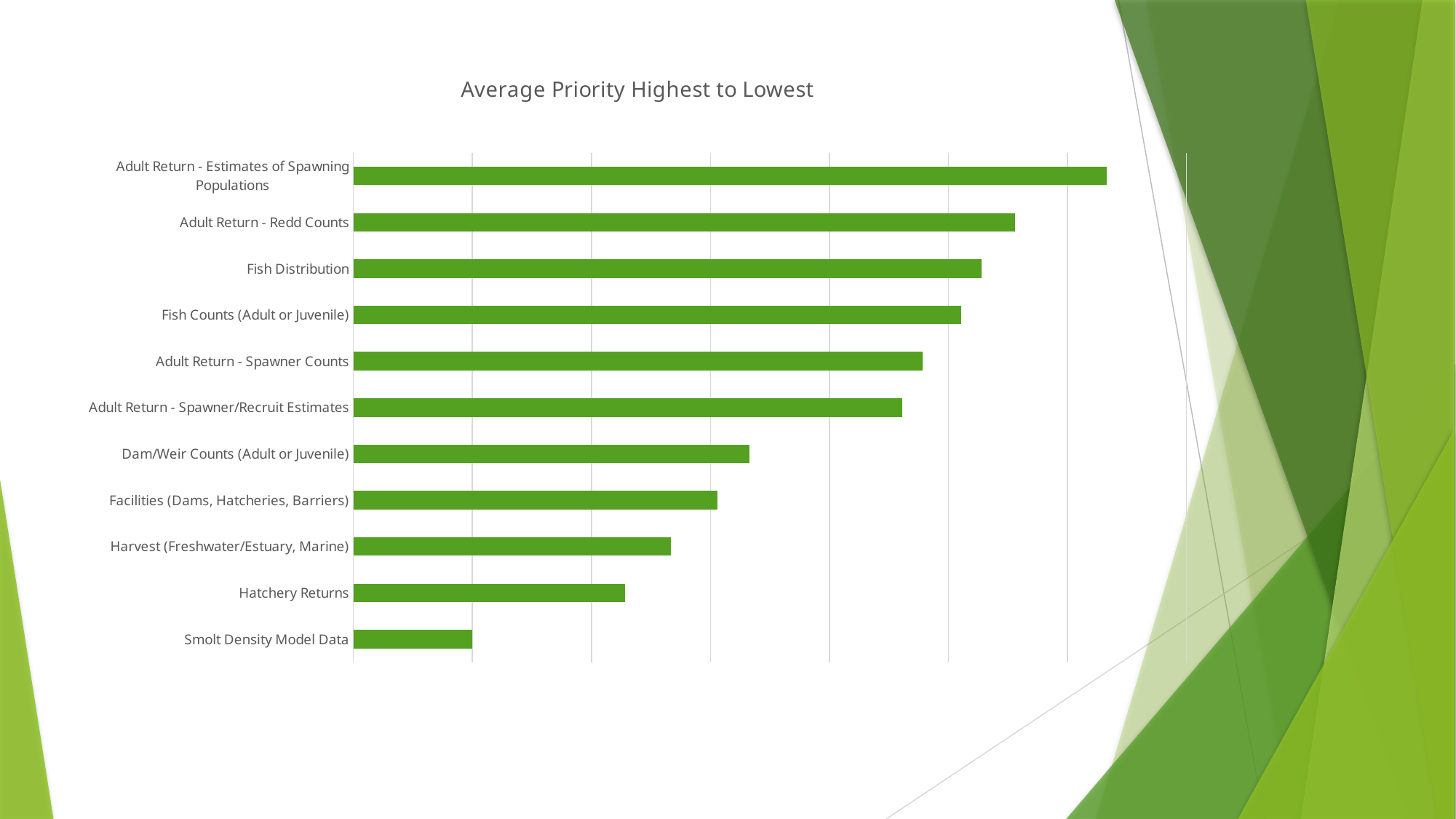
Which category has the second-highest average priority? Adult Return - Redd Counts What is the title of the chart? Average Priority Highest to Lowest How many categories are plotted in the chart? 11 Which has the larger value: Smolt Density Model Data or Facilities (Dams, Hatcheries, Barriers)? Facilities (Dams, Hatcheries, Barriers) Do the bar values increase or decrease going from the top category to the bottom category? decrease What colour are the bars in the chart? green Which has the larger value: Adult Return - Redd Counts or Adult Return - Spawner Counts? Adult Return - Redd Counts Which has the larger value: Dam/Weir Counts (Adult or Juvenile) or Harvest (Freshwater/Estuary, Marine)? Dam/Weir Counts (Adult or Juvenile) Which category has the lowest average priority? Smolt Density Model Data Which category has the highest average priority? Adult Return - Estimates of Spawning Populations What kind of chart is shown on the slide? bar chart